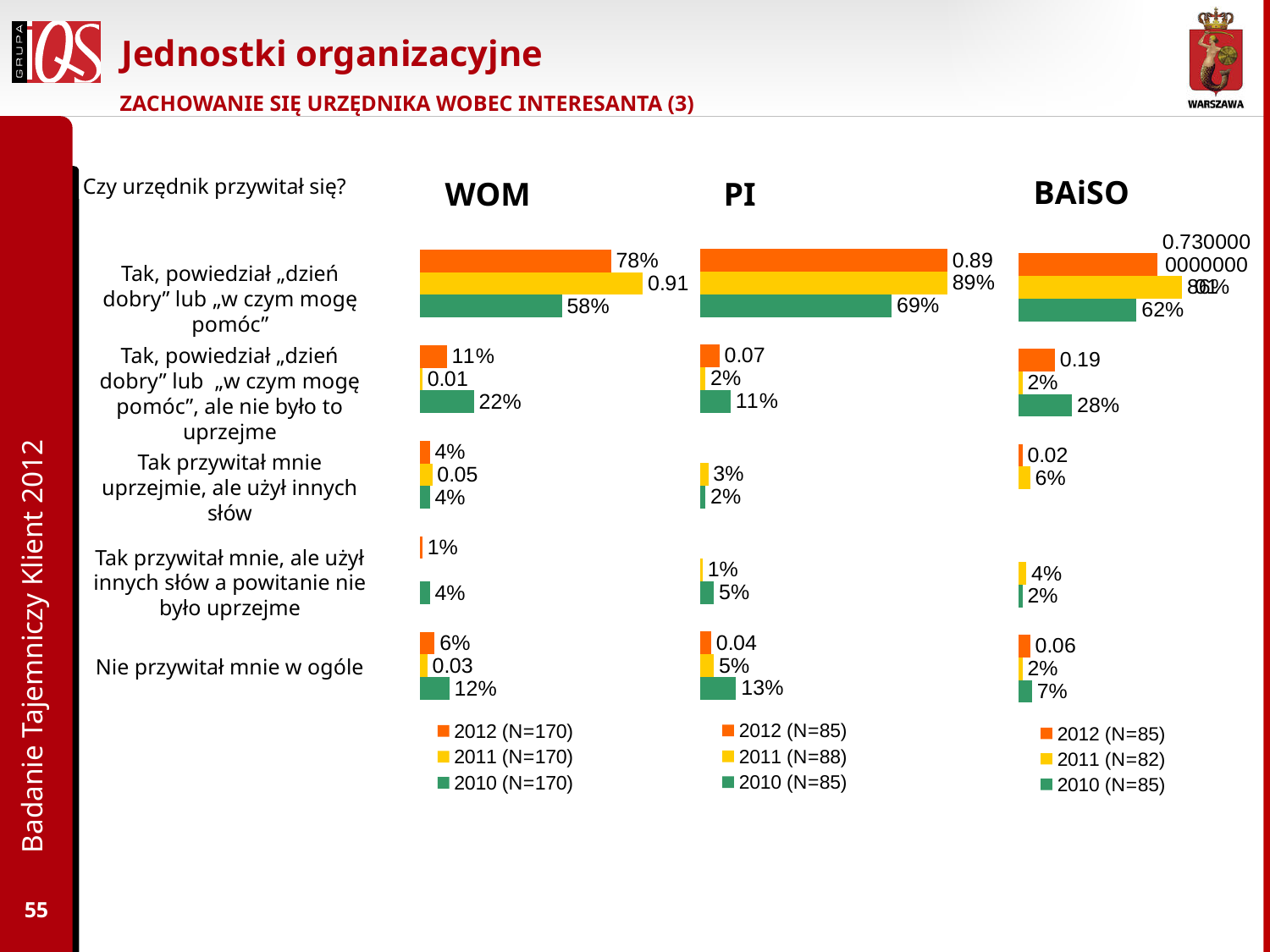
In the BAiSO chart, what is the 2010 value for "Nie przywitał mnie w ogóle"? 7% In the BAiSO chart, what is the 2010 value for "Tak, powiedział „dzień dobry” lub „w czym mogę pomóc”, ale nie było to uprzejme"? 28% In the WOM chart, for "Nie przywitał mnie w ogóle", which is larger: the 2010 value or the 2012 value? 2010 In the WOM chart, which category has the highest 2010 value? Tak, powiedział „dzień dobry” lub „w czym mogę pomóc” In the WOM chart, what is the 2012 value for "Nie przywitał mnie w ogóle"? 6% In the PI chart, what is the 2010 value for "Tak, powiedział „dzień dobry” lub „w czym mogę pomóc”"? 69% How many series does the legend of the WOM chart list? 3 In the PI chart, which category has the lowest 2010 value? Tak przywitał mnie uprzejmie, ale użył innych słów How many categories are shown in the PI chart? 5 In the PI chart, what is the 2011 value for "Tak przywitał mnie uprzejmie, ale użył innych słów"? 3% In the PI chart, what is the difference between the 2010 and 2011 values for "Nie przywitał mnie w ogóle"? 8 percentage points What kind of chart is the WOM chart? bar chart